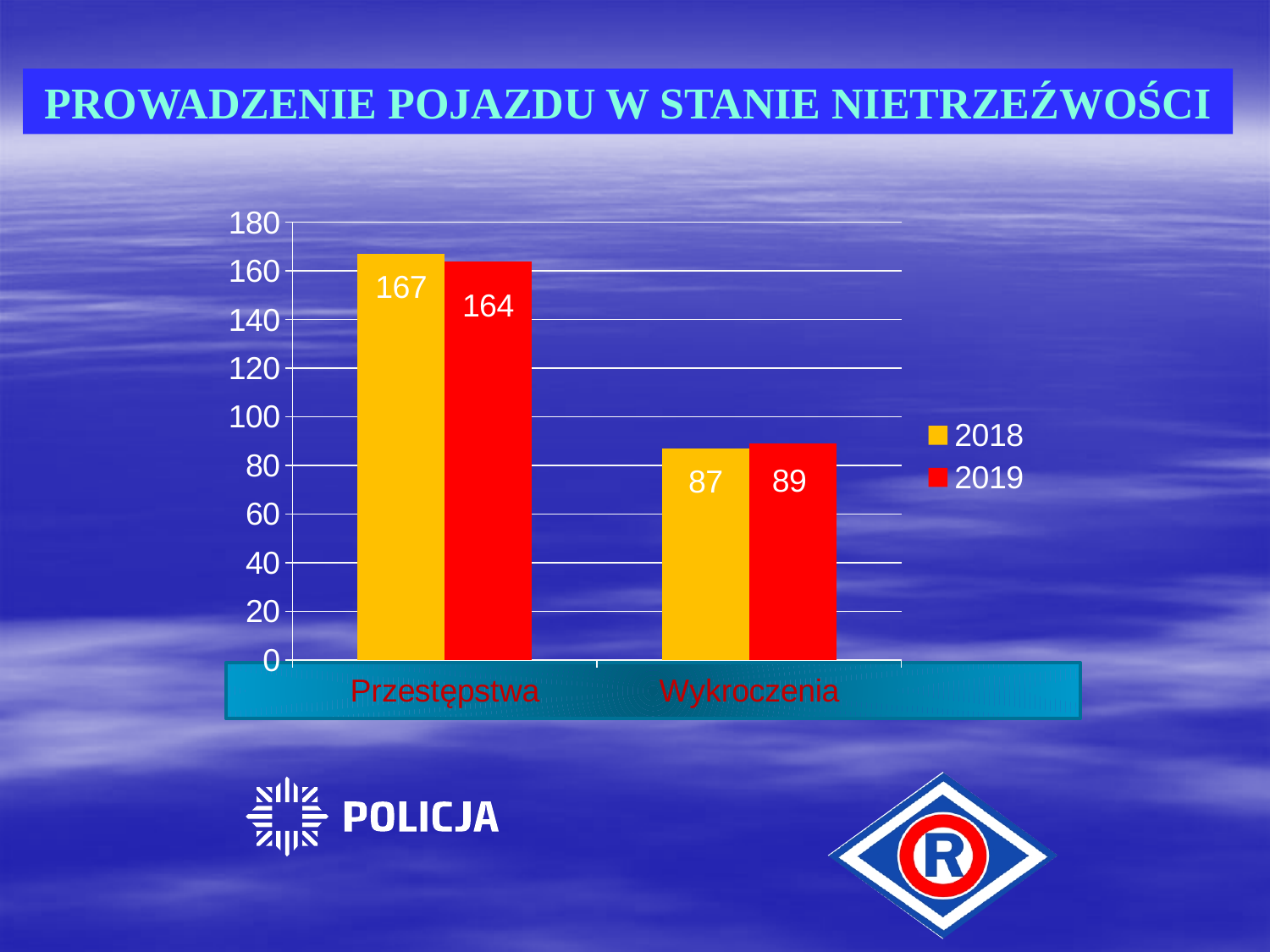
How many categories are shown on the x axis? 2 What is the value for Wykroczenia in 2019? 89 What kind of chart is shown on the slide? Bar chart What is the difference between the 2019 values for Przestępstwa and Wykroczenia? 75 Which category has the lowest value in 2019? Wykroczenia What is the value for Przestępstwa in 2018? 167 Which category has the highest value in 2018? Przestępstwa What is the value for Wykroczenia in 2018? 87 Which is larger: the 2018 value for Przestępstwa or the 2018 value for Wykroczenia? Przestępstwa How many series does the legend list? 2 What is the difference between the 2018 and 2019 values for Przestępstwa? 3 What is the value for Przestępstwa in 2019? 164